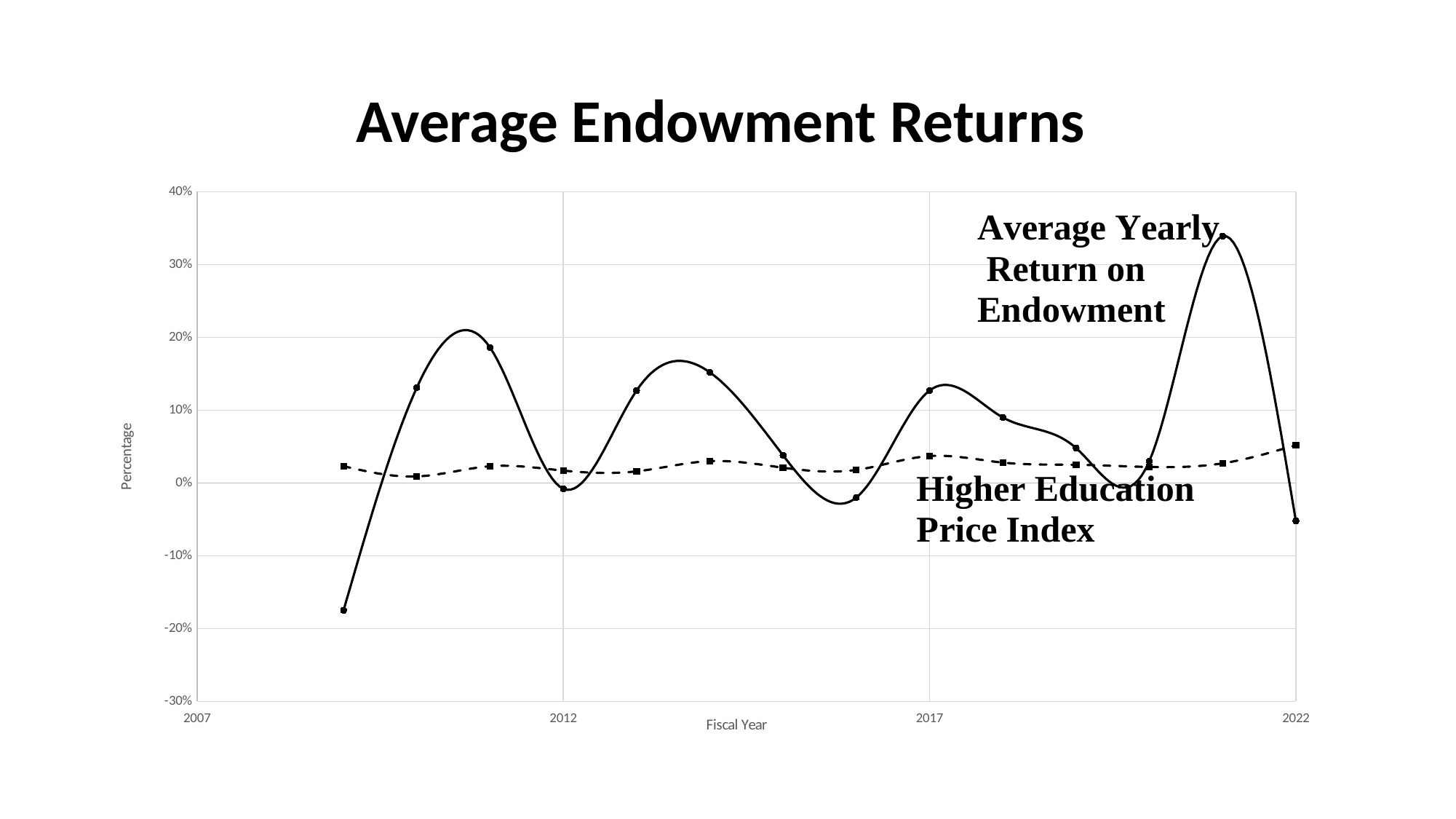
What is the title of the chart? Average Endowment Returns At 2022, which series has the higher value: Average Yearly Return on Endowment or Higher Education Price Index? Higher Education Price Index Is the Average Yearly Return on Endowment for 2022 greater or less than 0%? less At 2017, which series has the higher value: Average Yearly Return on Endowment or Higher Education Price Index? Average Yearly Return on Endowment Which series is drawn with a dashed line? Higher Education Price Index Is the highest point of the Average Yearly Return on Endowment series greater or less than 30%? greater Among the labelled years 2012, 2017 and 2022, which has the highest Average Yearly Return on Endowment? 2017 How many series are plotted on the chart? 2 Is the Average Yearly Return on Endowment for 2017 greater or less than 10%? greater What kind of chart is shown on the slide? Line chart